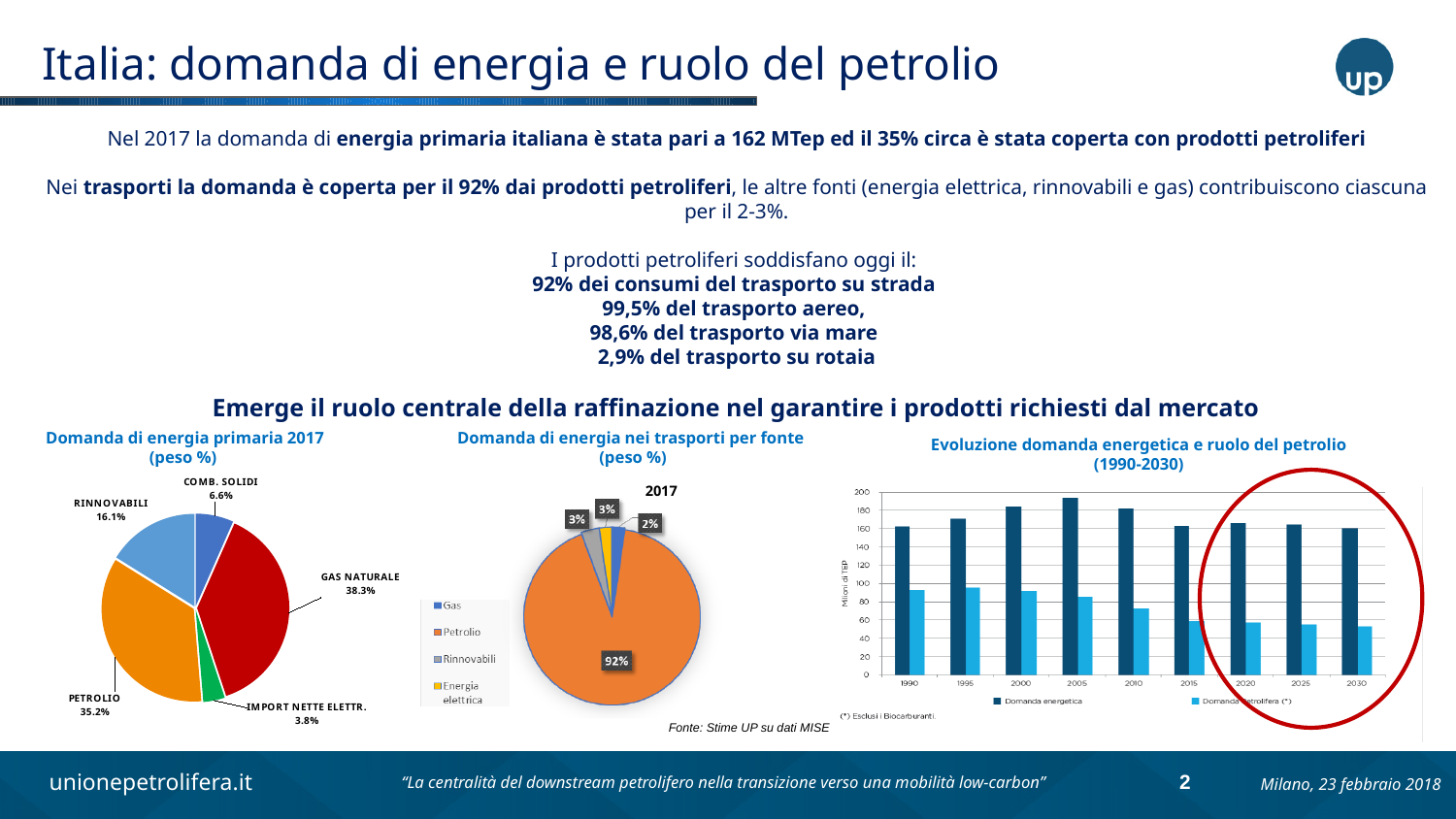
In the chart 'Evoluzione domanda energetica e ruolo del petrolio (1990-2030)', what kind of chart is shown? Bar chart In the chart 'Evoluzione domanda energetica e ruolo del petrolio (1990-2030)', how many years are shown on the x axis? 9 In the chart 'Domanda di energia primaria 2017 (peso %)', what is the share for Petrolio? 35.2% In the chart 'Evoluzione domanda energetica e ruolo del petrolio (1990-2030)', does the Domanda petrolifera series rise or fall from 1990 to 2030? Fall In the chart 'Domanda di energia nei trasporti per fonte (peso %)', what kind of chart is shown? Pie chart In the chart 'Evoluzione domanda energetica e ruolo del petrolio (1990-2030)', is the Domanda energetica value for 2005 greater or less than 180? greater In the chart 'Domanda di energia primaria 2017 (peso %)', which source has the largest share? Gas naturale In the chart 'Domanda di energia primaria 2017 (peso %)', how many slices does the pie have? 5 In the chart 'Domanda di energia nei trasporti per fonte (peso %)', how many entries does the legend list? 4 In the chart 'Domanda di energia nei trasporti per fonte (peso %)', what is the share for Petrolio? 92% In the chart 'Domanda di energia primaria 2017 (peso %)', what is the difference between the shares of Gas naturale and Petrolio? 3.1 percentage points In the chart 'Domanda di energia primaria 2017 (peso %)', which source has the smallest share? Import nette elettr.